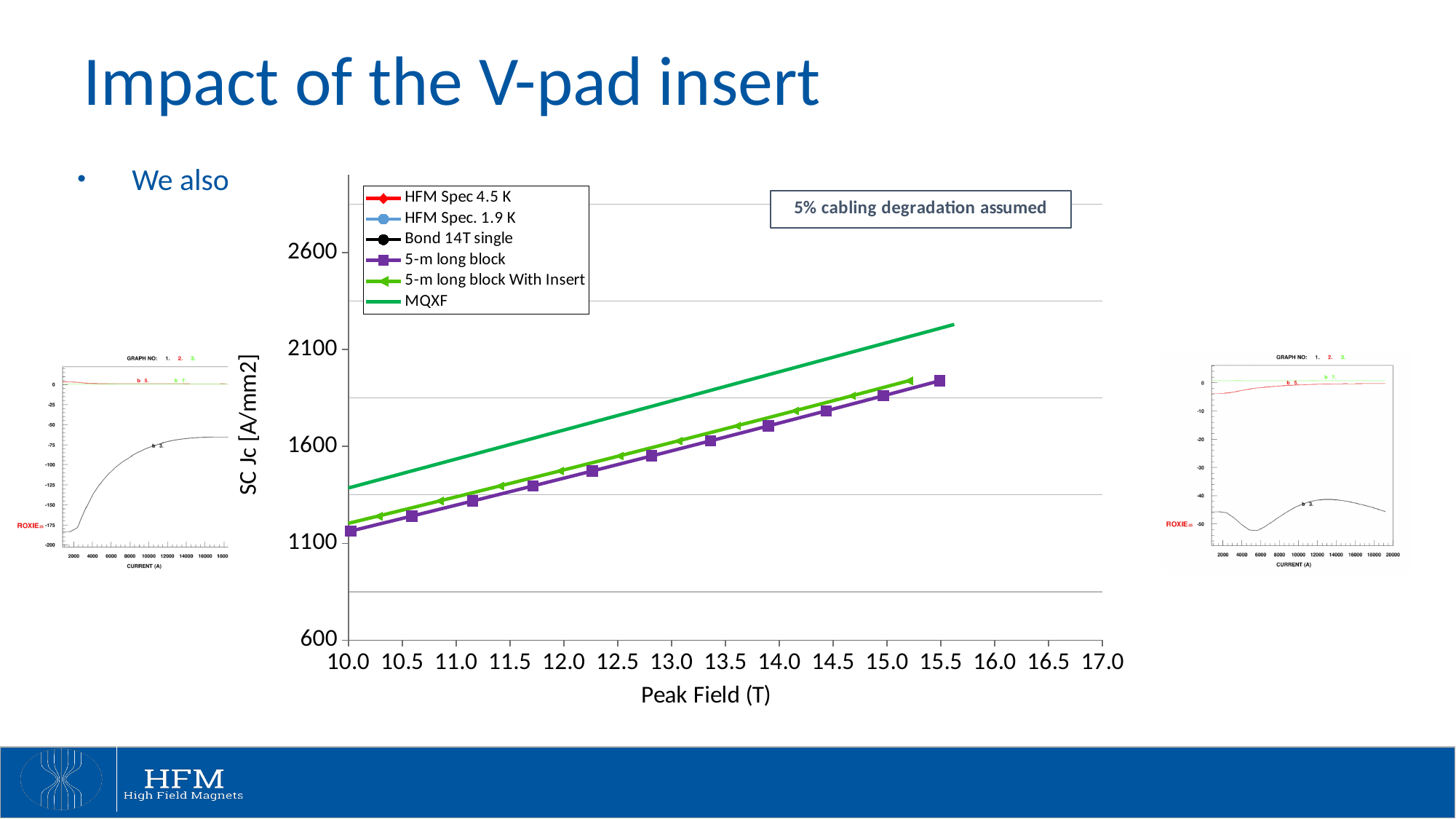
In the central chart, at a peak field of 13.0 T, which series has the larger SC Jc: MQXF or 5-m long block? MQXF What kind of chart is the central chart on the slide? line chart In the central chart, which plotted series has the lowest SC Jc values across the peak field range? 5-m long block In the central chart, which series has the highest SC Jc values across the plotted peak field range? MQXF In the central chart, at a peak field of 12.0 T, which series has the larger SC Jc: 5-m long block With Insert or 5-m long block? 5-m long block With Insert How many series does the legend of the central chart list? 6 In the central chart, is the MQXF value at 10.0 T greater or less than 1100? greater In the central chart, is the MQXF value at 15.5 T greater or less than 2100? greater In the central chart, is the 5-m long block value at 15.5 T greater or less than 2100? less What is the x-axis title of the central chart? Peak Field (T) In the central chart, do the SC Jc values rise or fall as Peak Field increases? rise What assumption is stated in the text box above the central chart? 5% cabling degradation assumed